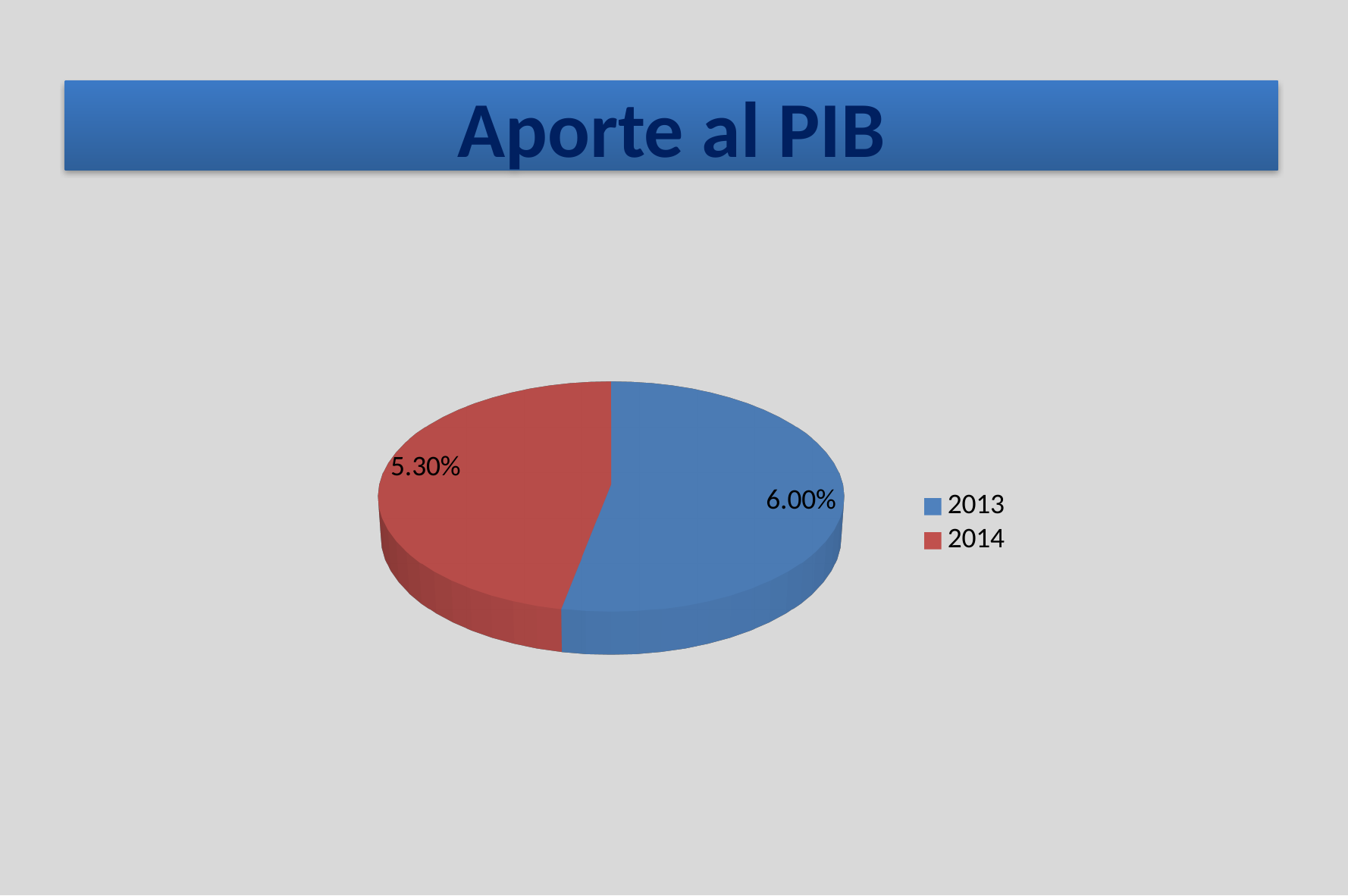
How many entries does the legend list? 2 What is the value shown for 2014? 5.30% What is the value shown for 2013? 6.00% How many slices does the pie chart have? 2 Which year has the smaller value? 2014 Which year has the larger value? 2013 What is the difference between the 2013 and 2014 values? 0.70% What is the title of the slide? Aporte al PIB What kind of chart is shown on the slide? pie chart Is the value for 2014 larger or smaller than the value for 2013? smaller Which colour represents 2014 in the pie chart? red